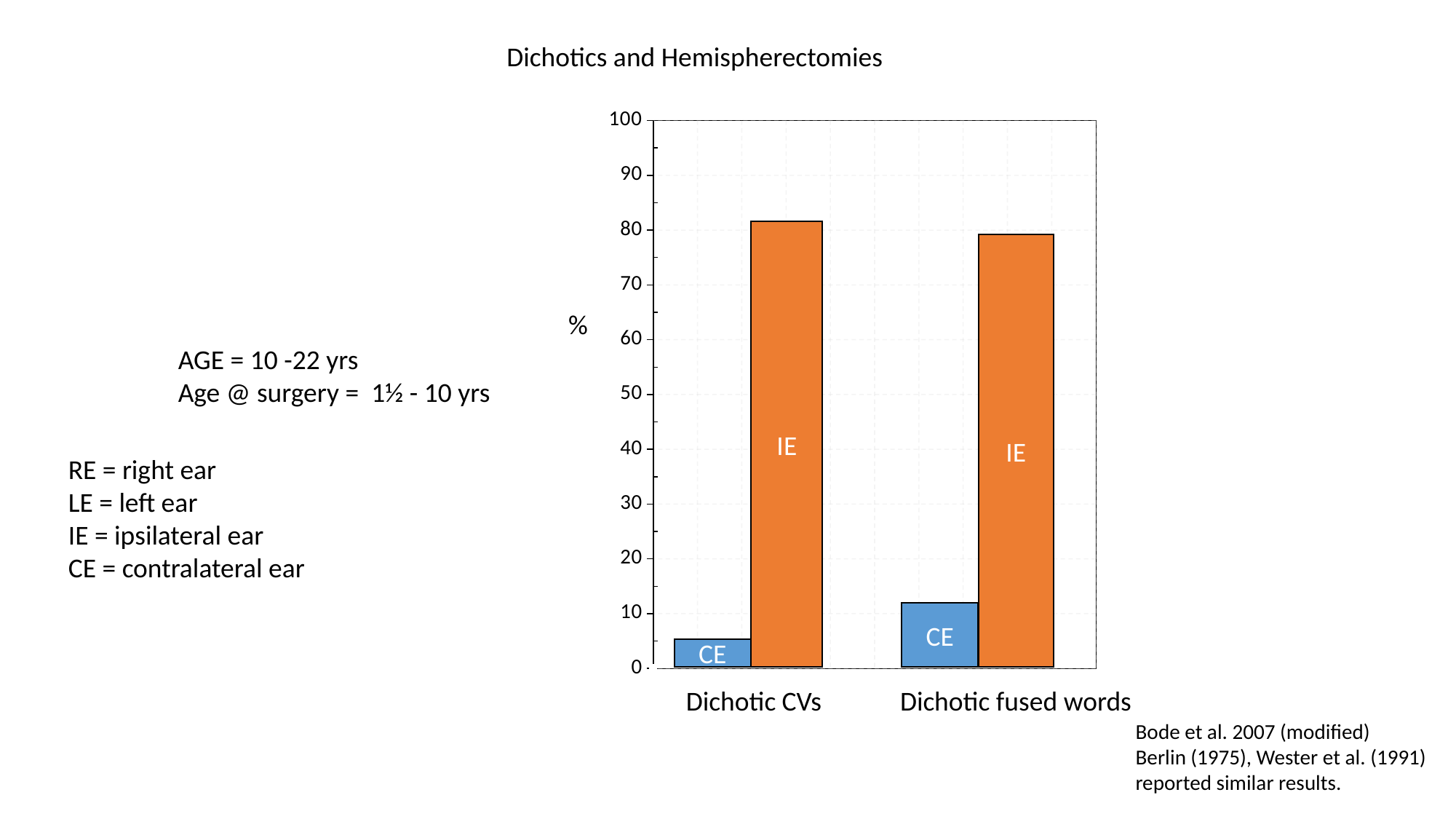
Is the IE value for Dichotic CVs greater or less than 80? greater Which bar in the chart is the highest? IE for Dichotic CVs Is the CE value for Dichotic CVs greater or less than 10? less Which category has the higher CE value, Dichotic CVs or Dichotic fused words? Dichotic fused words What is the title of the chart? Dichotics and Hemispherectomies Is the CE value for Dichotic fused words greater or less than 10? greater What kind of chart is shown on the slide? bar chart What label is shown on the y axis of the chart? % Which is larger for Dichotic CVs, the CE bar or the IE bar? IE Which bar in the chart is the lowest? CE for Dichotic CVs How many categories are shown on the x axis of the chart? 2